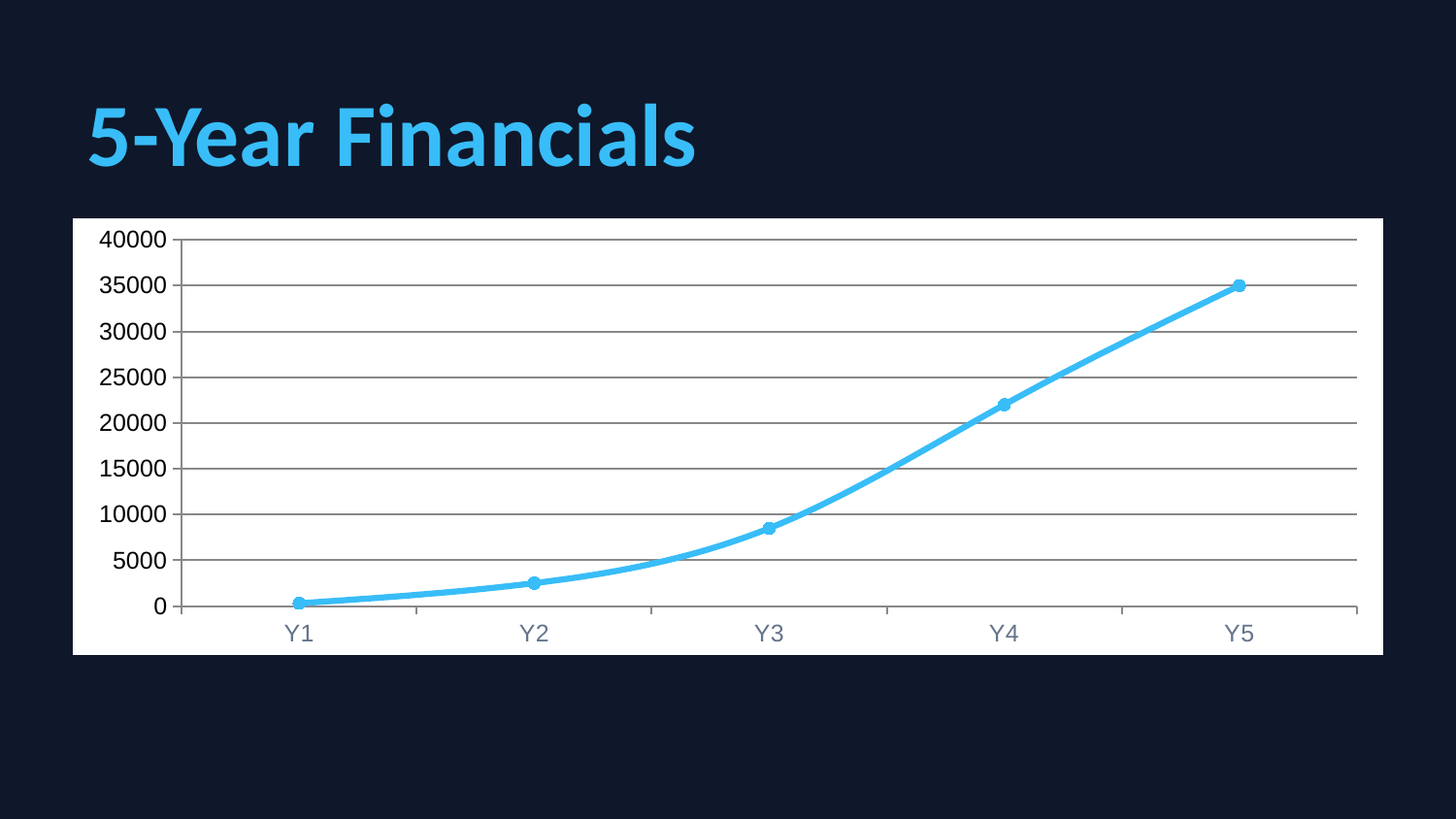
How many data points are plotted on the line? 5 What kind of chart is shown on the slide? line chart Is the value for Y3 greater or less than 10000? less What is the highest value shown on the vertical axis? 40000 What is the title of the slide's chart? 5-Year Financials Which year has the lowest value? Y1 Which is larger, the value for Y4 or the value for Y3? Y4 Is the value for Y2 greater or less than 5000? less What is the value for Y5? 35000 Which year has the highest value? Y5 Is the value for Y4 greater or less than 20000? greater Do the values rise or fall from Y1 to Y5? rise